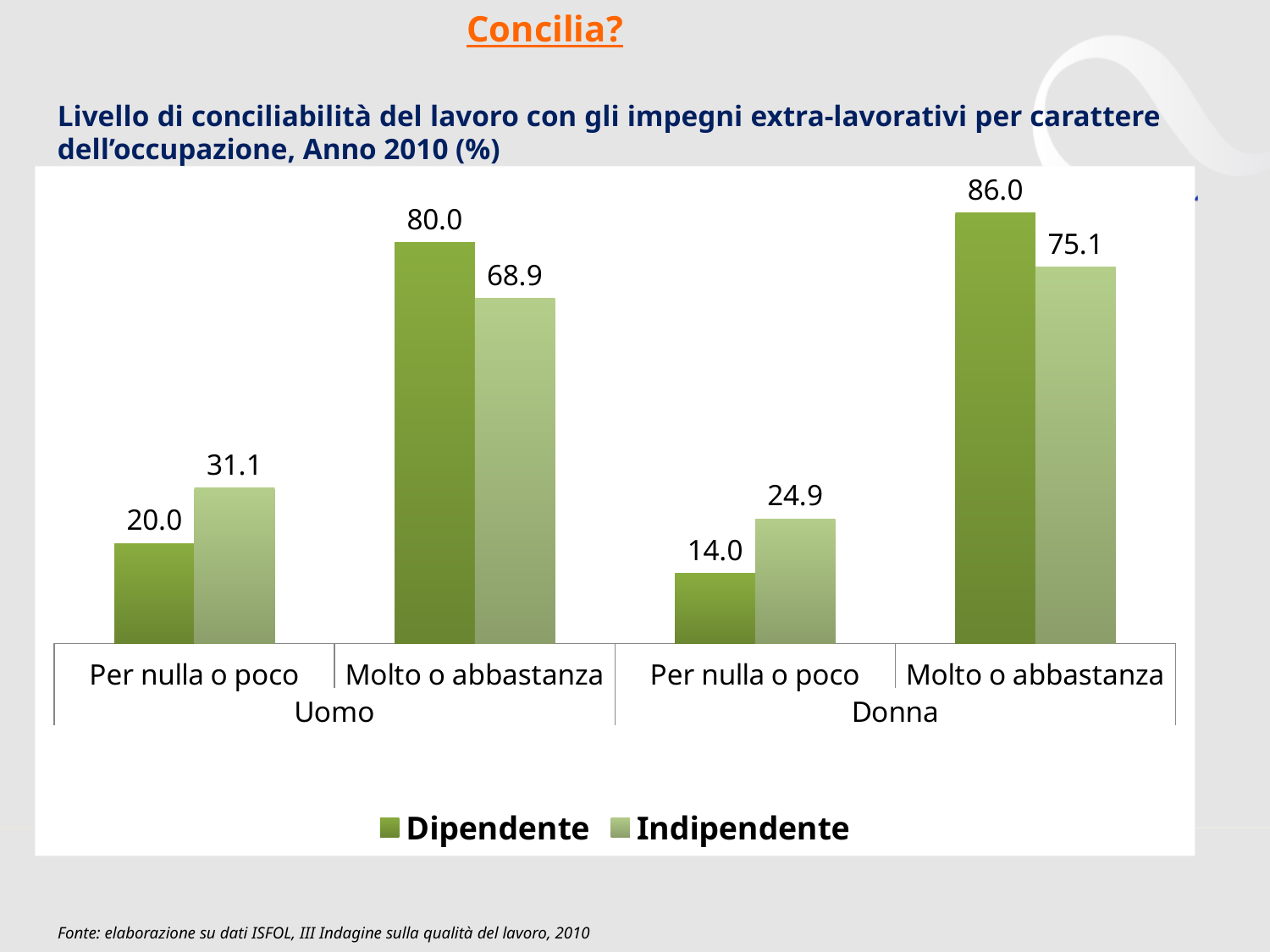
How many series does the legend list? 2 What is the value for Dipendente in the 'Molto o abbastanza' category for Uomo? 80.0 What is the value for Dipendente in the 'Per nulla o poco' category for Uomo? 20.0 Which bar has the lowest value in the chart? Dipendente, Per nulla o poco (Donna) What is the value for Indipendente in the 'Per nulla o poco' category for Donna? 24.9 What are the two series named in the legend? Dipendente and Indipendente In the 'Per nulla o poco' category for Donna, which series has the larger value, Dipendente or Indipendente? Indipendente How many categories are shown on the x axis? 4 What is the difference between the Dipendente and Indipendente values in the 'Molto o abbastanza' category for Uomo? 11.1 What is the value for Indipendente in the 'Molto o abbastanza' category for Donna? 75.1 Which bar has the highest value in the chart? Dipendente, Molto o abbastanza (Donna) What kind of chart is shown on the slide? Bar chart